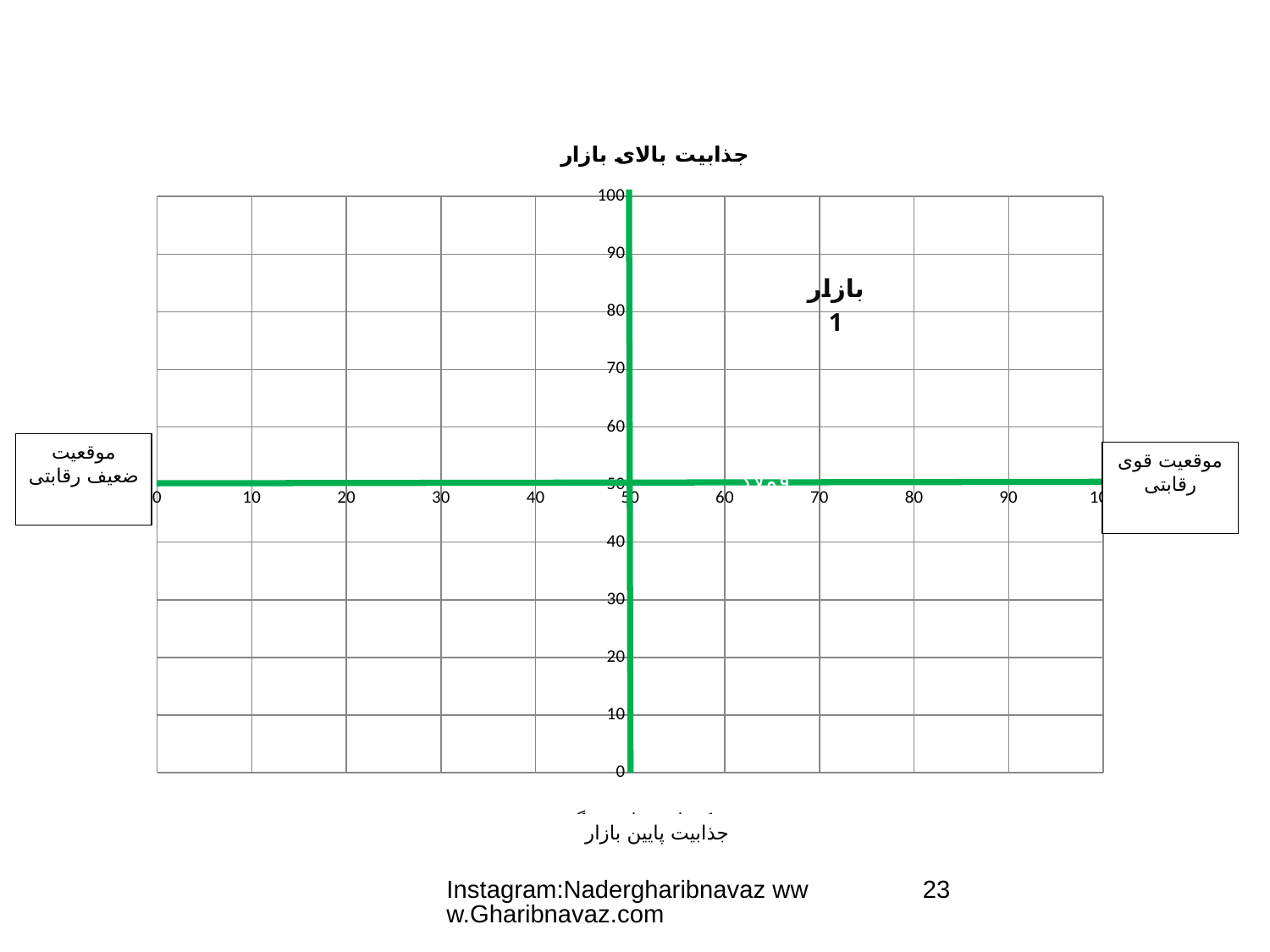
At what value on the horizontal axis does the thick green vertical line cross? 50 What kind of chart is shown on the slide? scatter chart Is the vertical position of the label بازار 1 greater or less than 90? less Is the vertical position of the label بازار 1 greater or less than 50? greater At what value on the vertical axis does the thick green horizontal line cross? 50 Is the horizontal position of the label بازار 1 greater or less than 50? greater What is the interval between consecutive tick labels on the vertical axis? 10 How many tick labels are printed on the vertical axis? 11 What is the maximum value shown on the vertical axis? 100 How many labeled data points (markets) are shown on the chart? 1